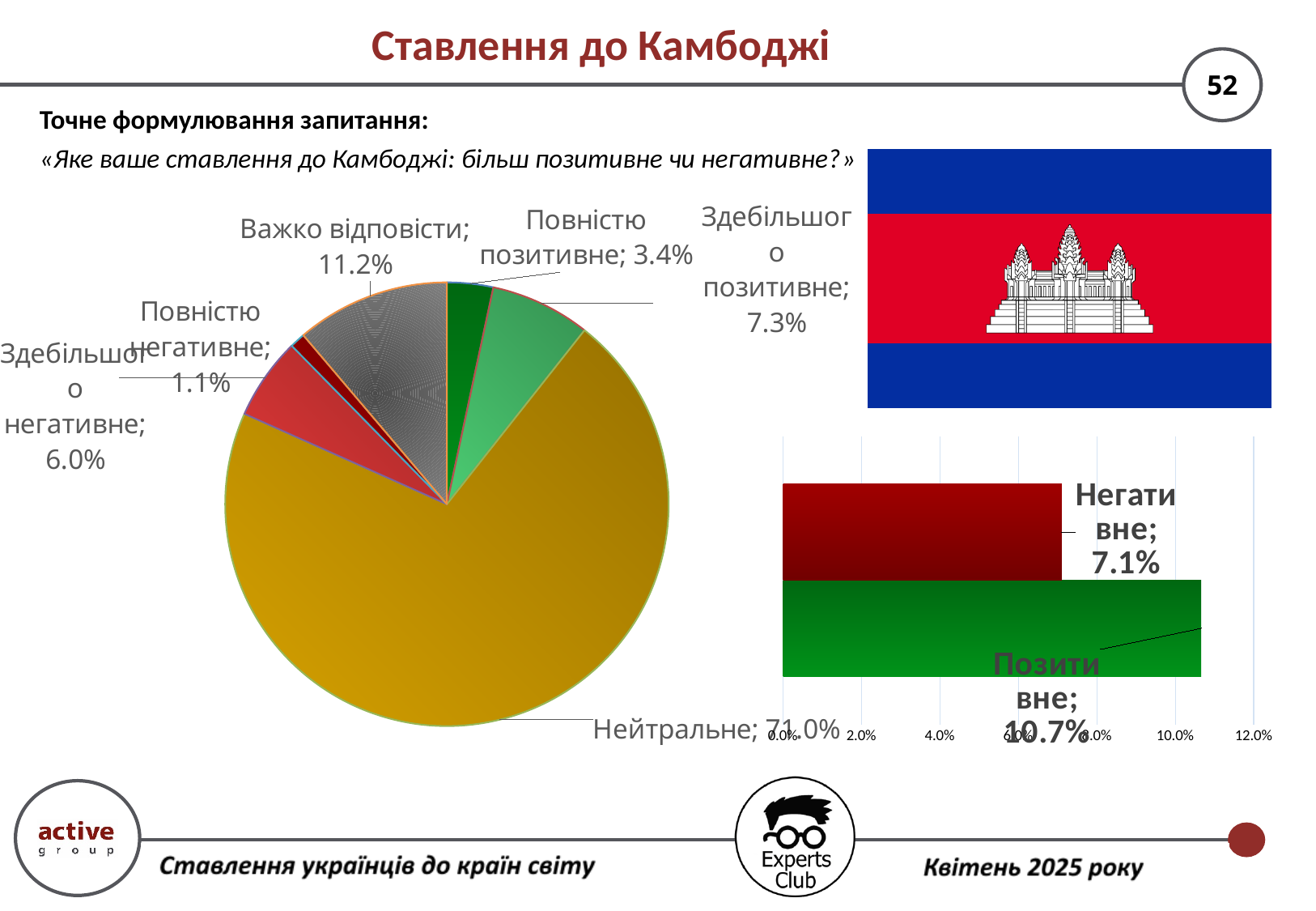
In the bar chart on the right, what is the value for "Позитивне"? 10.7% In the pie chart, what share is labelled for "Нейтральне"? 71.0% In the pie chart, what is the difference between "Здебільшого позитивне" and "Здебільшого негативне"? 1.3% In the pie chart, what is the value for "Важко відповісти"? 11.2% In the pie chart, how many categories are shown? 6 In the bar chart on the right, what is the difference between "Позитивне" and "Негативне"? 3.6% In the pie chart, which category has the largest share? Нейтральне In the bar chart on the right, what is the value for "Негативне"? 7.1% In the pie chart, what is the value for "Здебільшого позитивне"? 7.3% In the pie chart, which is larger: "Повністю позитивне" or "Повністю негативне"? Повністю позитивне In the pie chart, which category has the smallest share? Повністю негативне What type of chart is shown on the right side of the slide below the flag? Bar chart